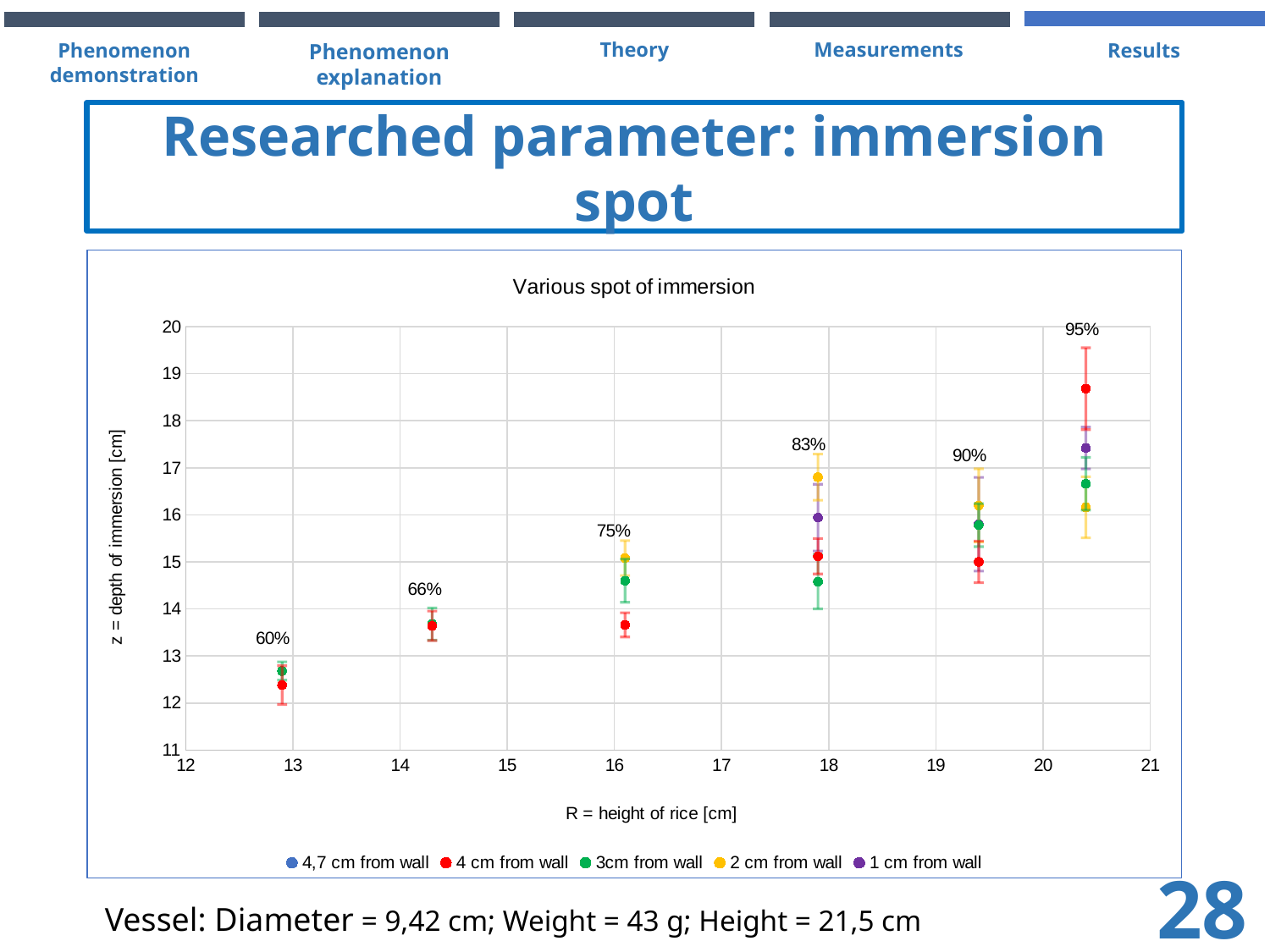
Which series has the highest point in the 95% group? 4 cm from wall Do the values for '4 cm from wall' generally rise or fall as R increases? rise Is the value for '4 cm from wall' in the 60% group greater or less than 13? less In the 83% group, which is higher: '2 cm from wall' or '3cm from wall'? 2 cm from wall What is the title of the chart? Various spot of immersion How many series does the legend list? 5 What kind of chart is shown on the slide? scatter chart Is the value for '4 cm from wall' in the 95% group greater or less than 18? greater How many percentage labels are printed above the groups of points? 6 What percentage label is printed above the rightmost group of points? 95% What percentage label is printed above the leftmost group of points? 60% Is the value for '3cm from wall' in the 75% group greater or less than 14? greater